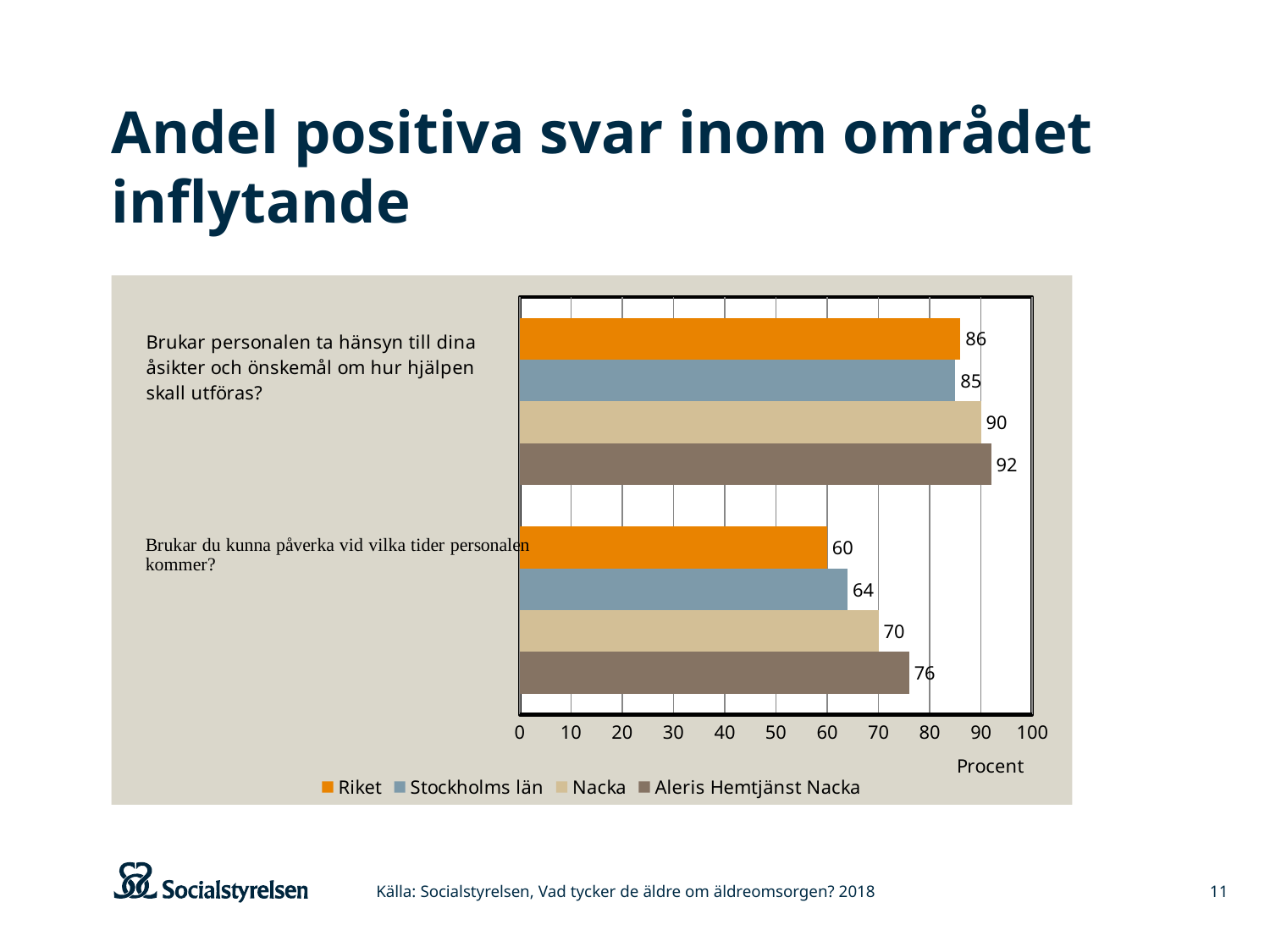
What kind of chart is shown on the slide? Bar chart Which series has the highest value on the question "Brukar du kunna påverka vid vilka tider personalen kommer?"? Aleris Hemtjänst Nacka What is the value for Nacka on the question "Brukar du kunna påverka vid vilka tider personalen kommer?"? 70 Which series has the lowest value on the question "Brukar du kunna påverka vid vilka tider personalen kommer?"? Riket What colour are the bars for Riket? Orange What is the label on the horizontal axis of the chart? Procent What is the difference between the Aleris Hemtjänst Nacka value and the Riket value on the question "Brukar du kunna påverka vid vilka tider personalen kommer?"? 16 What is the value for Aleris Hemtjänst Nacka on the question "Brukar personalen ta hänsyn till dina åsikter och önskemål om hur hjälpen skall utföras?"? 92 How many series does the legend list? 4 What is the value for Riket on the question "Brukar du kunna påverka vid vilka tider personalen kommer?"? 60 What is the value for Stockholms län on the question "Brukar personalen ta hänsyn till dina åsikter och önskemål om hur hjälpen skall utföras?"? 85 Which is larger on the question "Brukar personalen ta hänsyn till dina åsikter och önskemål om hur hjälpen skall utföras?": Nacka or Stockholms län? Nacka